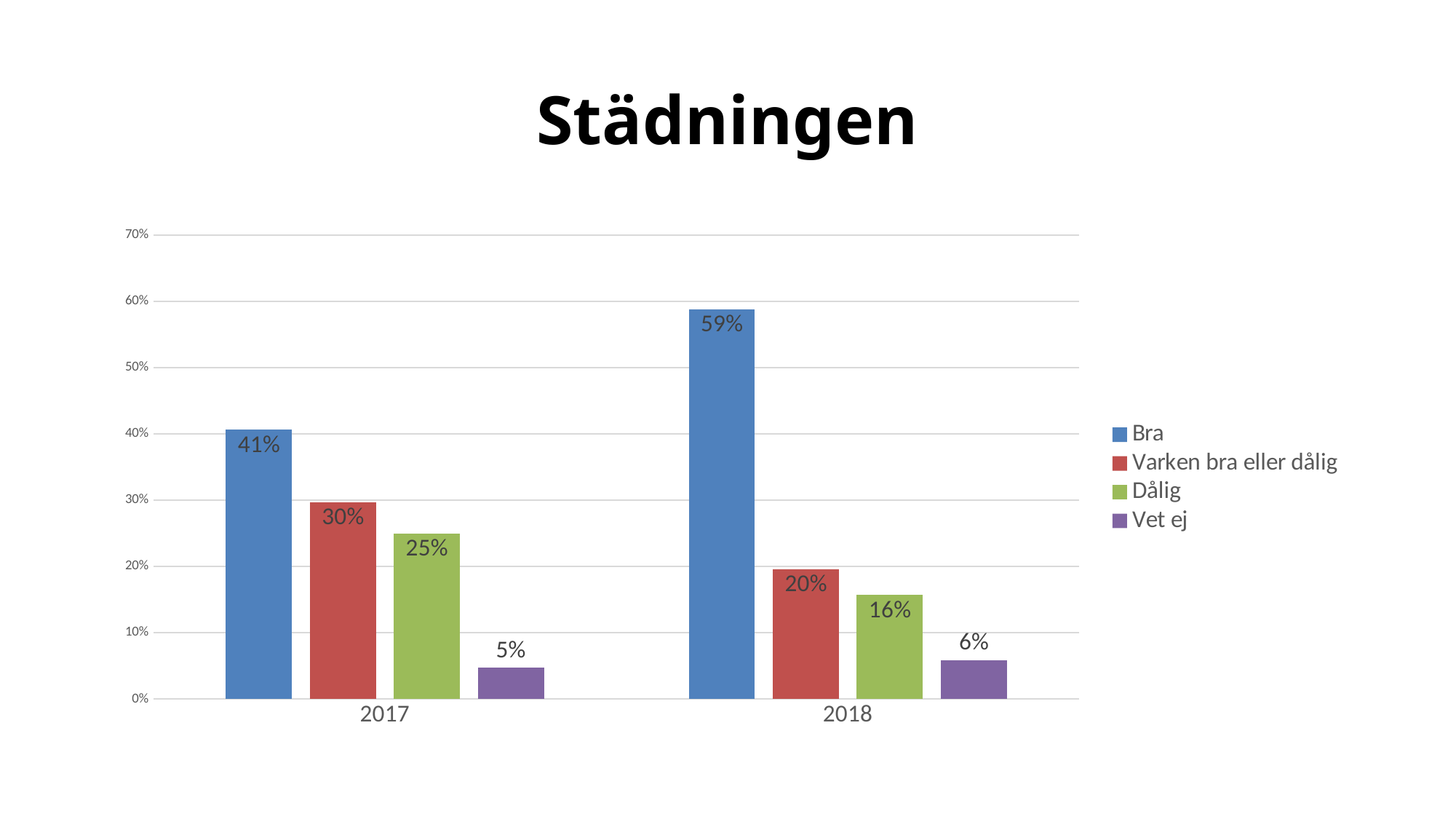
Which is larger: Dålig in 2017 or Dålig in 2018? Dålig in 2017 What is the value for Vet ej in 2017? 5% How many categories are shown on the x axis? 2 Which series has the lowest value in 2017? Vet ej What is the value for Dålig in 2018? 16% What is the title of the slide? Städningen How many series does the legend list? 4 What is the value for Varken bra eller dålig in 2017? 30% What is the difference between the Bra value in 2018 and the Bra value in 2017? 18% What is the value for Bra in 2018? 59% What kind of chart is shown on the slide? Bar chart Which series has the highest value in 2018? Bra